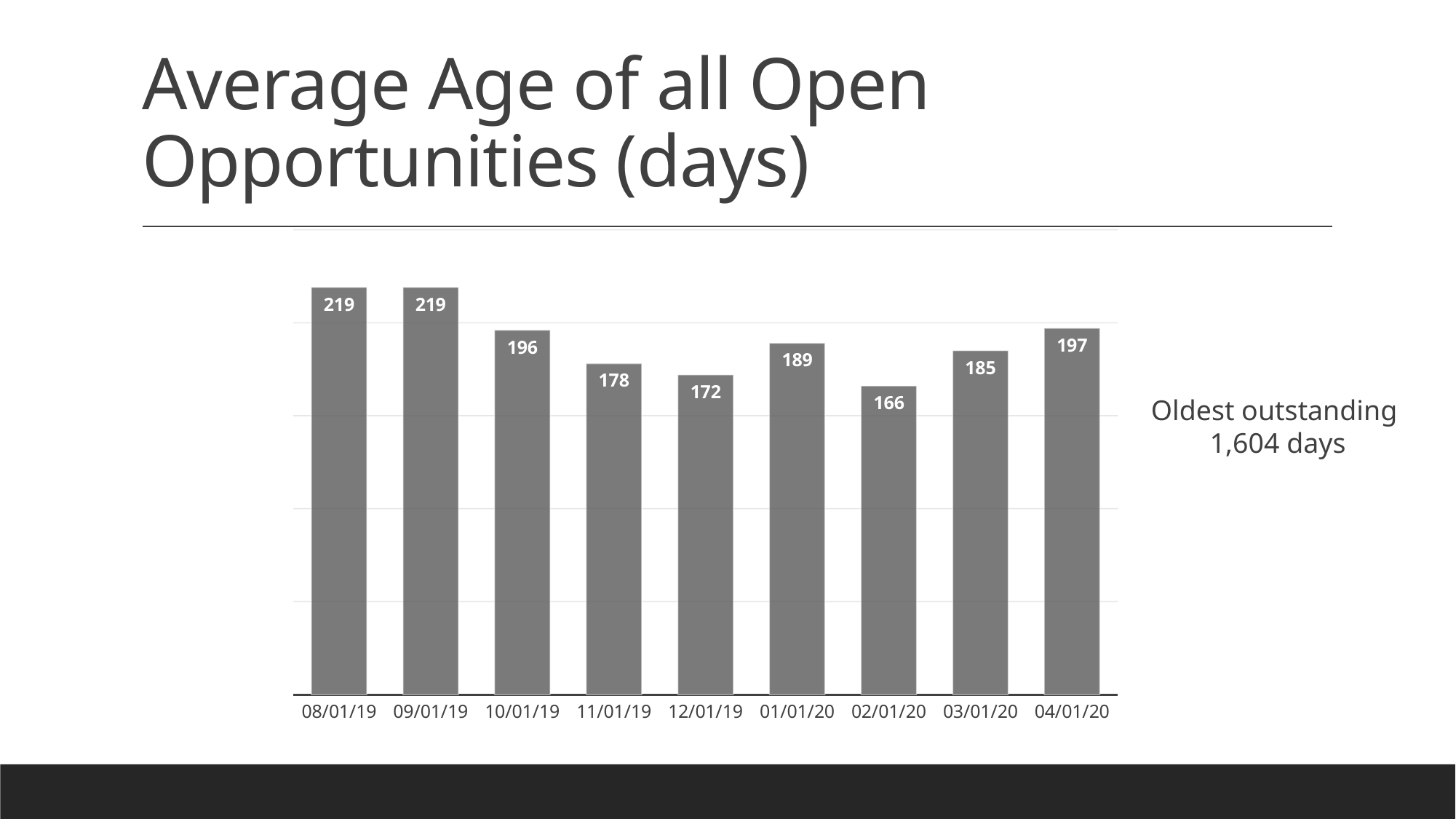
What is the average age of open opportunities on 10/01/19? 196 What is the value shown for 04/01/20? 197 What is the highest value shown on the chart? 219 According to the text next to the chart, how old is the oldest outstanding opportunity? 1,604 days What is the value shown for 02/01/20? 166 How many dates are shown on the x axis of the chart? 9 What is the difference between the values for 08/01/19 and 02/01/20? 53 What kind of chart is shown on the slide? Bar chart What is the difference between the values for 04/01/20 and 03/01/20? 12 Do the values rise or fall from 12/01/19 to 01/01/20? Rise Which is larger, the value for 11/01/19 or the value for 01/01/20? 01/01/20 Which date has the lowest average age of open opportunities? 02/01/20